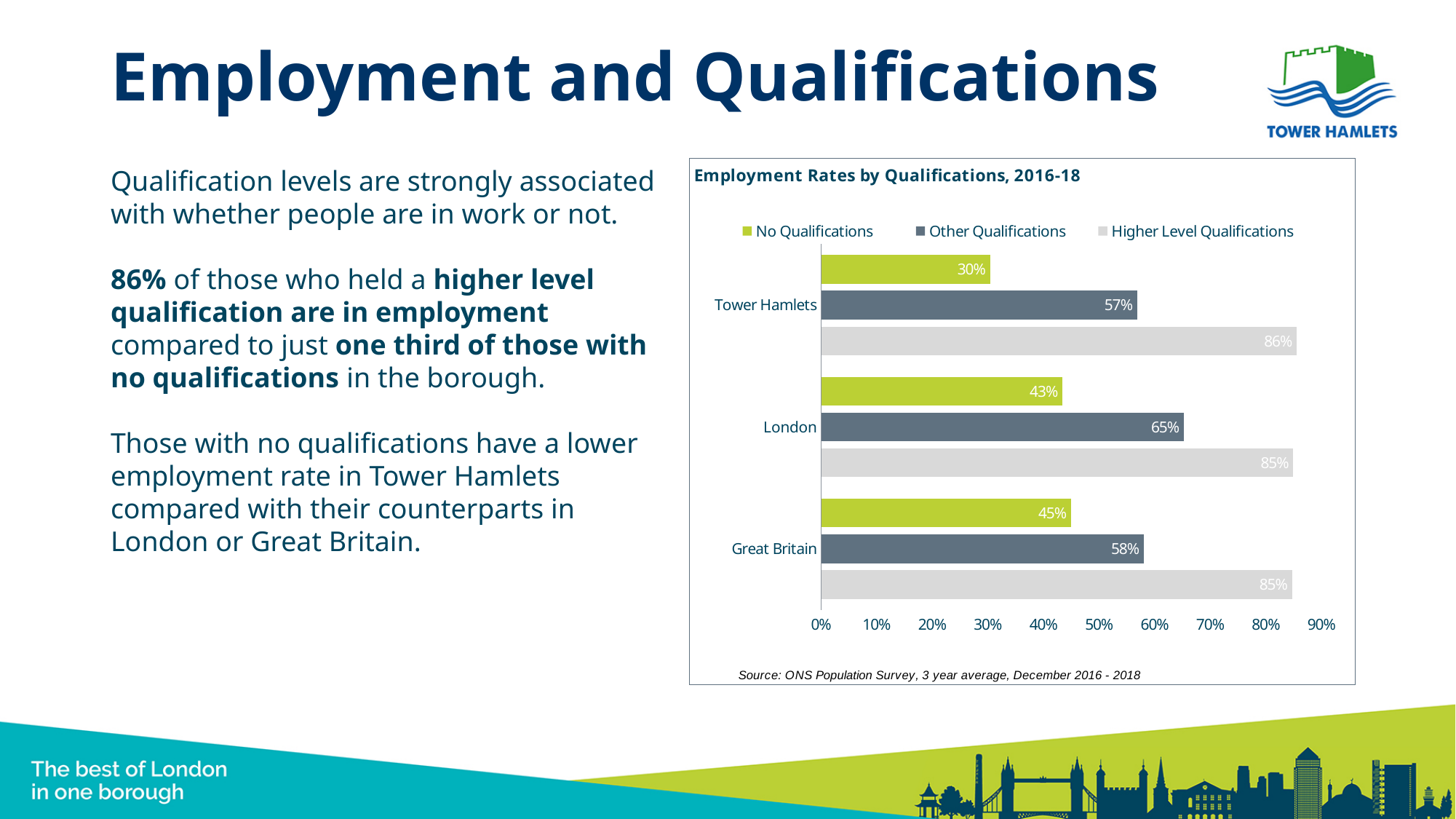
Which is larger: the Other Qualifications employment rate in Tower Hamlets or in Great Britain? Great Britain What is the difference between the Higher Level Qualifications and No Qualifications employment rates in Tower Hamlets? 56% What kind of chart is shown on the slide? Bar chart What is the difference between the No Qualifications employment rates in Great Britain and Tower Hamlets? 15% Which area has the highest employment rate for people with Other Qualifications? London What is the employment rate for people with No Qualifications in Tower Hamlets? 30% What is the title of the chart? Employment Rates by Qualifications, 2016-18 What is the employment rate for people with Higher Level Qualifications in London? 85% What is the employment rate for people with Other Qualifications in Great Britain? 58% How many areas are shown on the chart? 3 Which area has the lowest employment rate for people with No Qualifications? Tower Hamlets How many series does the legend list? 3